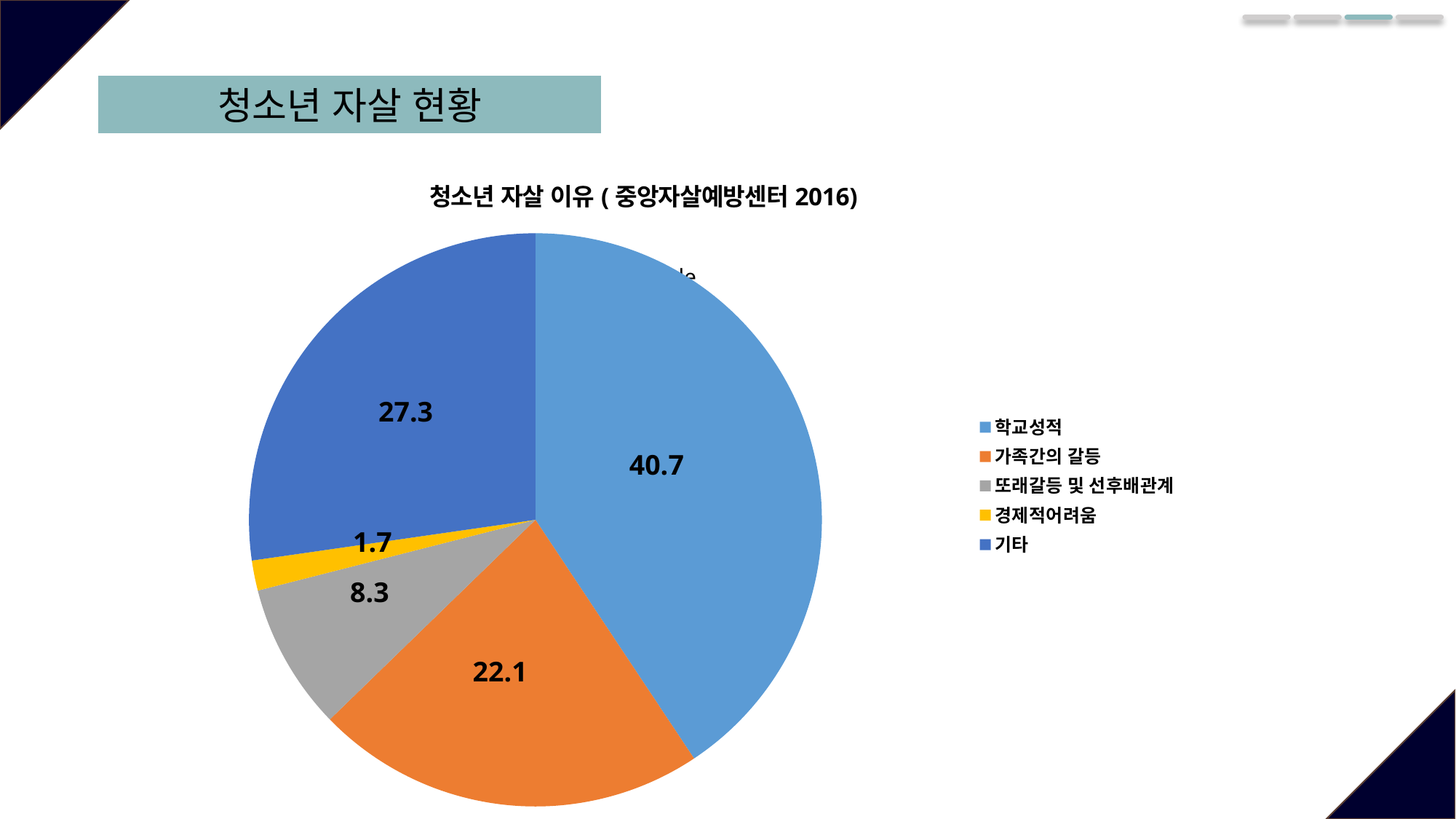
What is the difference between the values for 학교성적 and 기타? 13.4 What is the value for 또래갈등 및 선후배관계? 8.3 Which category has the smallest slice? 경제적어려움 Which category has the largest slice? 학교성적 What type of chart is shown on the slide? pie chart What is the value for 기타? 27.3 How many categories does the legend list? 5 What is the value for 경제적어려움? 1.7 What is the title of the chart? 청소년 자살 이유 ( 중앙자살예방센터 2016) What is the value for 학교성적? 40.7 What is the value for 가족간의 갈등? 22.1 Which is larger, 가족간의 갈등 or 기타? 기타